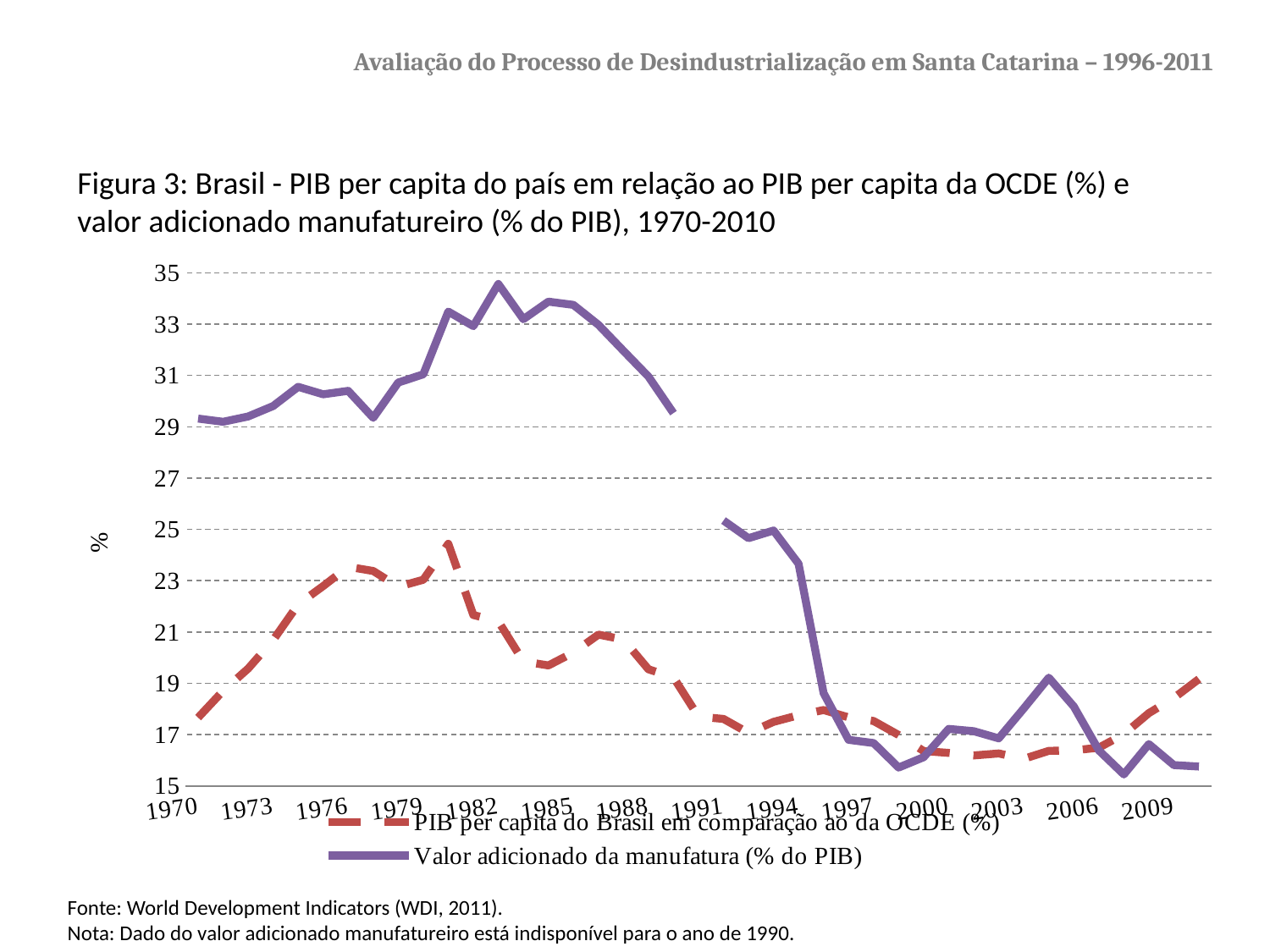
Is the value for PIB per capita do Brasil em comparação ao da OCDE (%) in 1970 greater or less than 19? less In 2010, which series has the higher value: Valor adicionado da manufatura (% do PIB) or PIB per capita do Brasil em comparação ao da OCDE (%)? PIB per capita do Brasil em comparação ao da OCDE (%) Is the value for Valor adicionado da manufatura (% do PIB) in 1970 greater or less than 27? greater Which series is drawn with a dashed line? PIB per capita do Brasil em comparação ao da OCDE (%) In 1970, which series has the higher value: Valor adicionado da manufatura (% do PIB) or PIB per capita do Brasil em comparação ao da OCDE (%)? Valor adicionado da manufatura (% do PIB) Is the value for Valor adicionado da manufatura (% do PIB) in 2008 greater or less than 17? less What kind of chart is shown on the slide? Line chart What is the label on the vertical axis? % How many series does the legend list? 2 Does the Valor adicionado da manufatura (% do PIB) series rise or fall between 1994 and 1997? fall